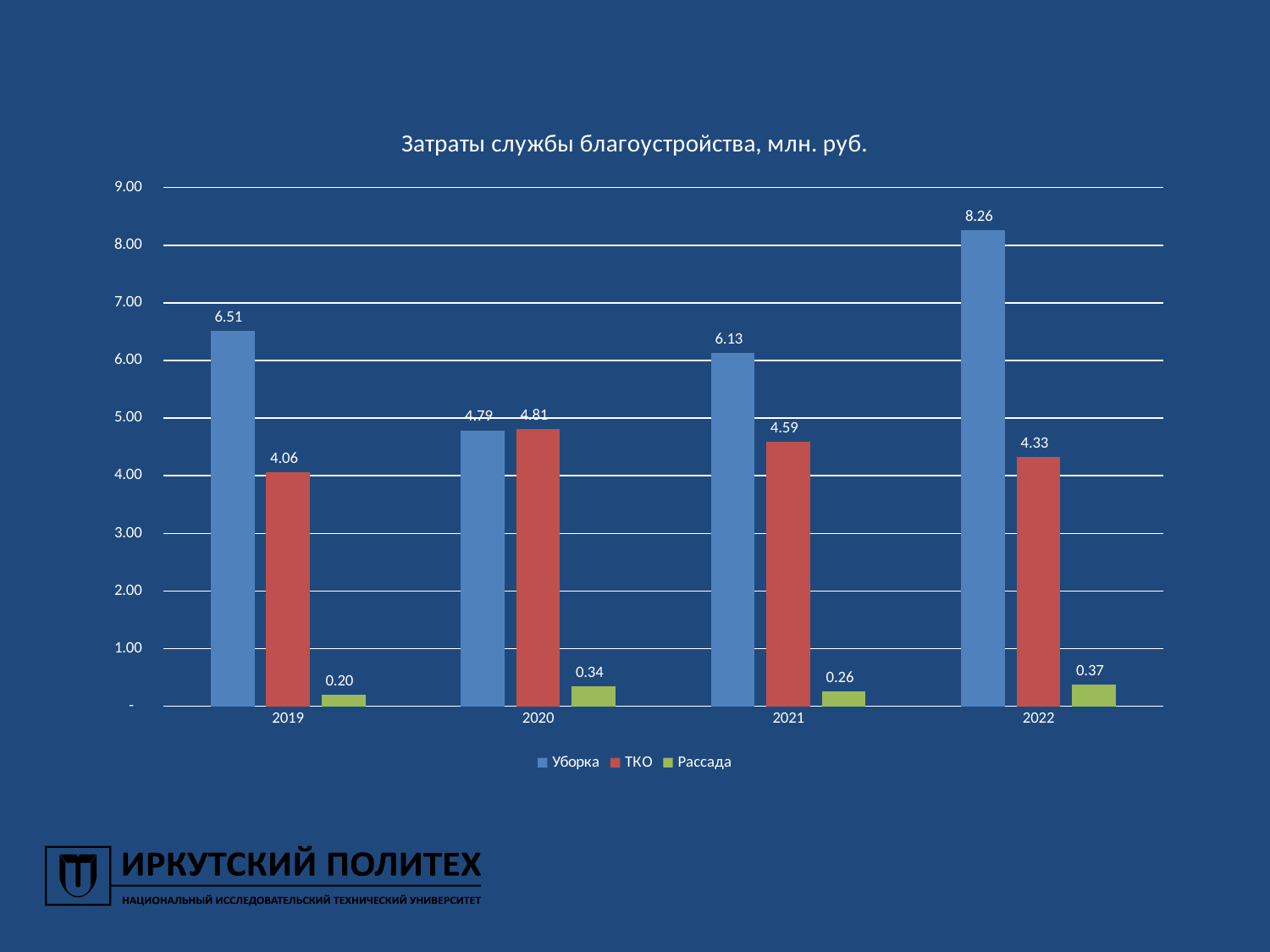
What is the title of the chart? Затраты службы благоустройства, млн. руб. In which year is the Уборка value highest? 2022 What is the value for Рассада in 2020? 0.34 What kind of chart is shown on the slide? Bar chart What is the value for Уборка in 2022? 8.26 What is the value for ТКО in 2019? 4.06 Which is larger in 2020: Уборка or ТКО? ТКО How many years are shown on the x axis? 4 In which year is the Рассада value lowest? 2019 Is the value for Уборка in 2019 greater or less than 6.00? greater How many series does the legend list? 3 What is the difference between the Уборка values for 2022 and 2021? 2.13